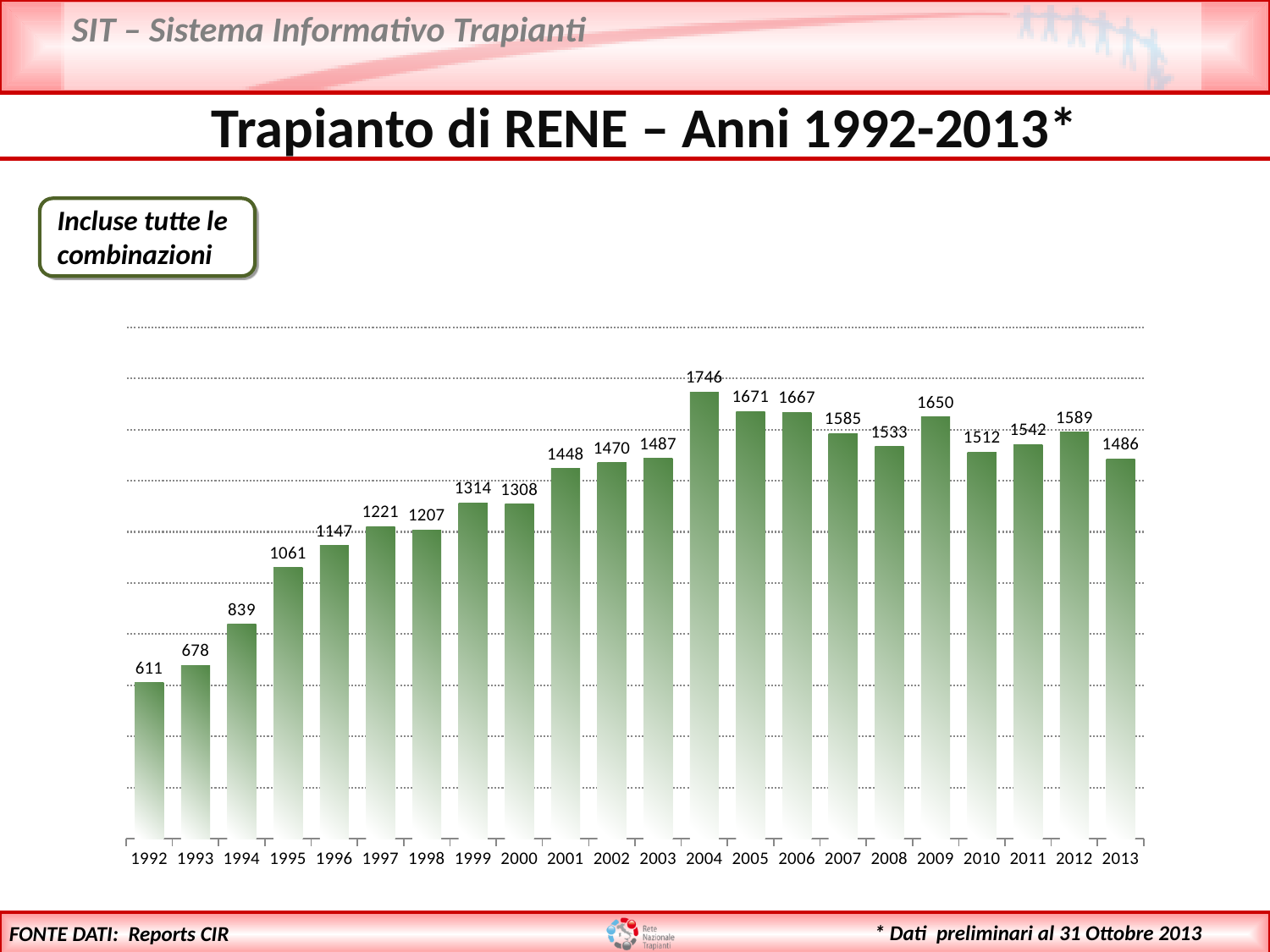
What type of chart is shown on the slide? bar chart Which year has the lowest value? 1992 Do the values generally rise or fall from 1992 to 2004? rise What is the value for 2013? 1486 What is the difference between the values for 2004 and 2013? 260 What is the value for 1992? 611 What is the title of the slide containing the chart? Trapianto di RENE – Anni 1992-2013* What is the difference between the values for 1993 and 1992? 67 Which year has the highest value? 2004 What is the value for 2004? 1746 Which is larger, the value for 2009 or the value for 2012? 2009 How many years are shown on the x axis? 22